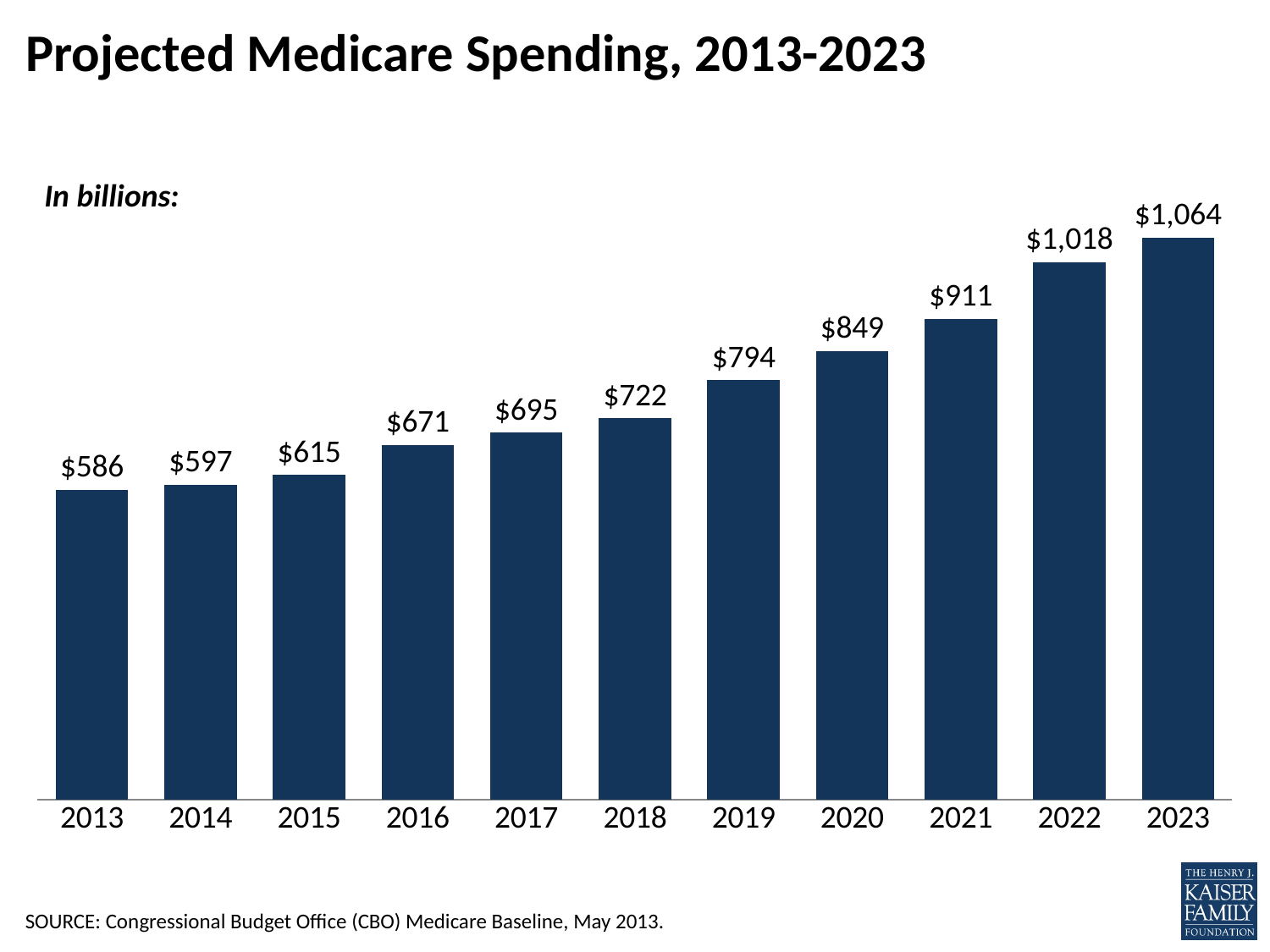
Which year has the lowest projected Medicare spending? 2013 Which year has higher projected Medicare spending, 2016 or 2021? 2021 What is the difference between projected Medicare spending in 2023 and 2013? $478 Do the projected Medicare spending values rise or fall from 2013 to 2023? Rise What is the title of the chart? Projected Medicare Spending, 2013-2023 What is the projected Medicare spending for 2013? $586 How many years are shown on the chart? 11 What kind of chart is shown on the slide? Bar chart What is the difference between projected Medicare spending in 2020 and 2019? $55 What is the projected Medicare spending for 2018? $722 What is the projected Medicare spending for 2022? $1,018 Which year has the highest projected Medicare spending? 2023